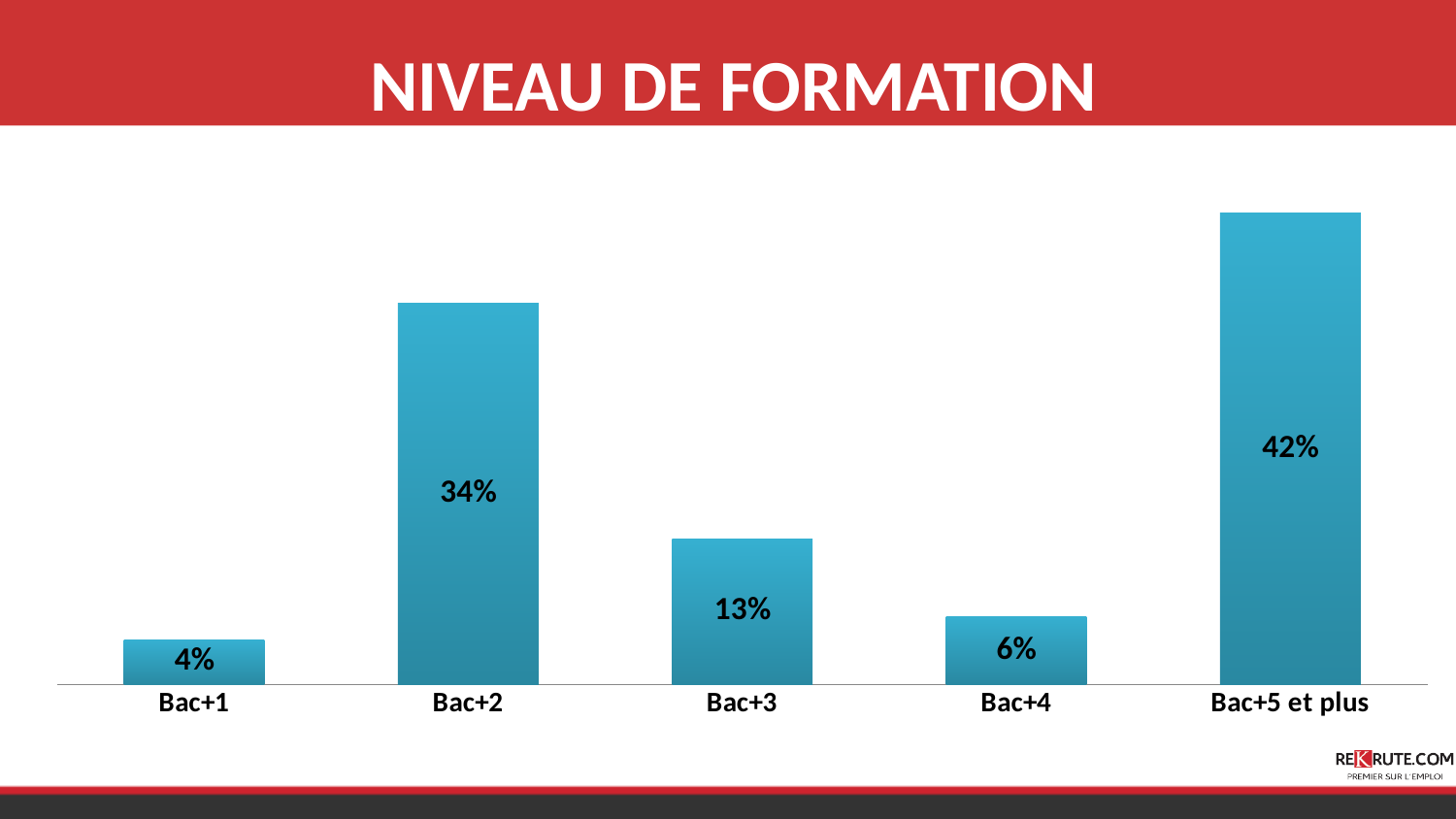
What is the difference between the values for Bac+5 et plus and Bac+2? 8% Which is larger, the value for Bac+3 or the value for Bac+4? Bac+3 What is the title of the slide? NIVEAU DE FORMATION Which category has the highest value? Bac+5 et plus What is the value for Bac+3? 13% What is the value for Bac+5 et plus? 42% How many categories are shown in the chart? 5 What is the value for Bac+2? 34% What is the value for Bac+1? 4% What kind of chart is shown on the slide? Bar chart What is the difference between the values for Bac+3 and Bac+4? 7% Which category has the lowest value? Bac+1